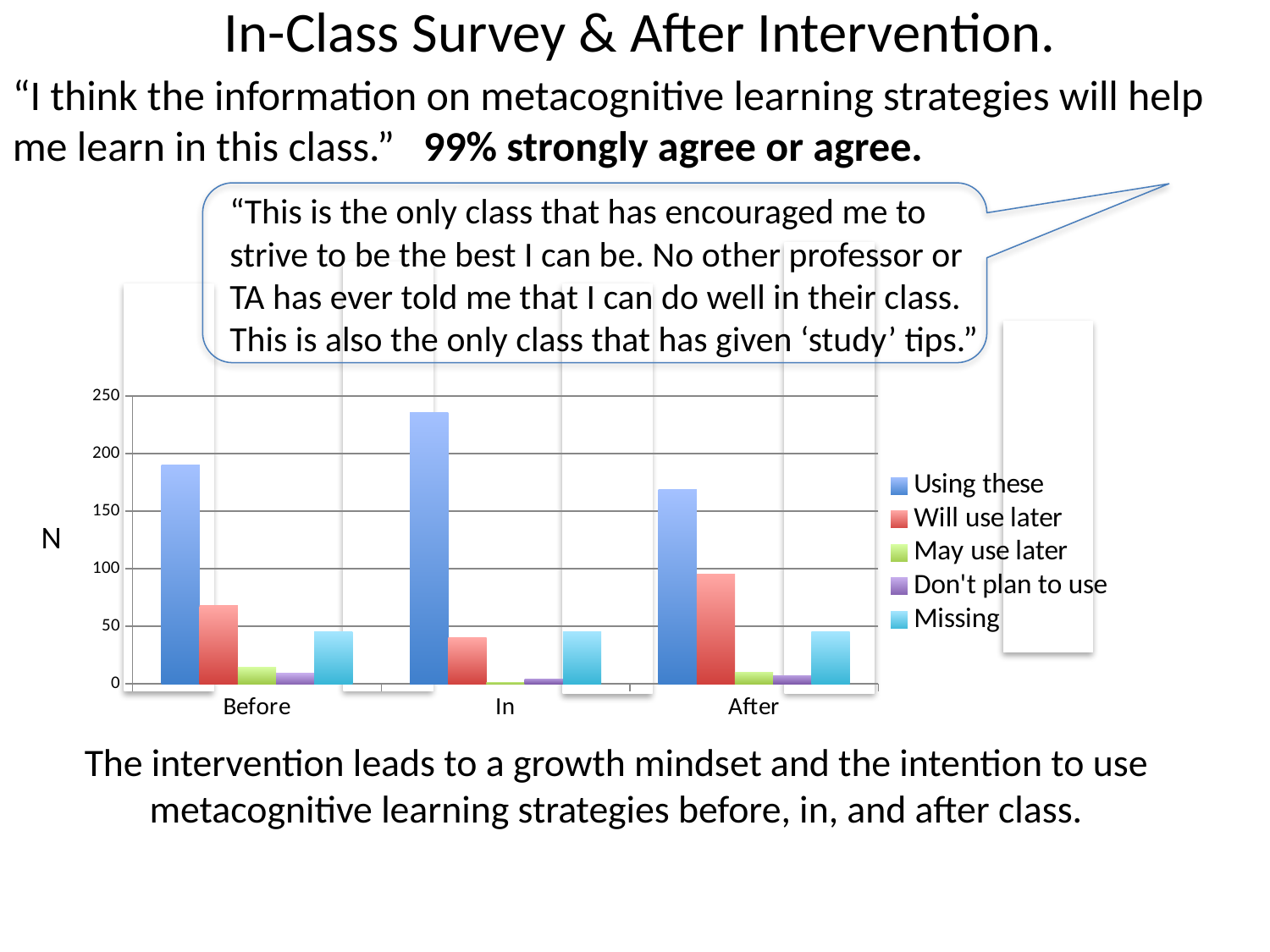
Is the value for "Using these" in the After category greater or less than 200? less In which category is the value for "Using these" highest? In What is the label on the y axis of the chart? N What kind of chart is shown on the slide? bar chart Which is larger in the Before category: "Using these" or "Will use later"? Using these In which category is the value for "Will use later" highest? After Is the value for "Using these" in the In category greater or less than 200? greater Which is larger in the After category: "Will use later" or "Missing"? Will use later How many series does the chart's legend list? 5 In which category is the value for "Will use later" lowest? In How many categories are shown on the x axis of the chart? 3 Is the value for "Will use later" in the Before category greater or less than 50? greater